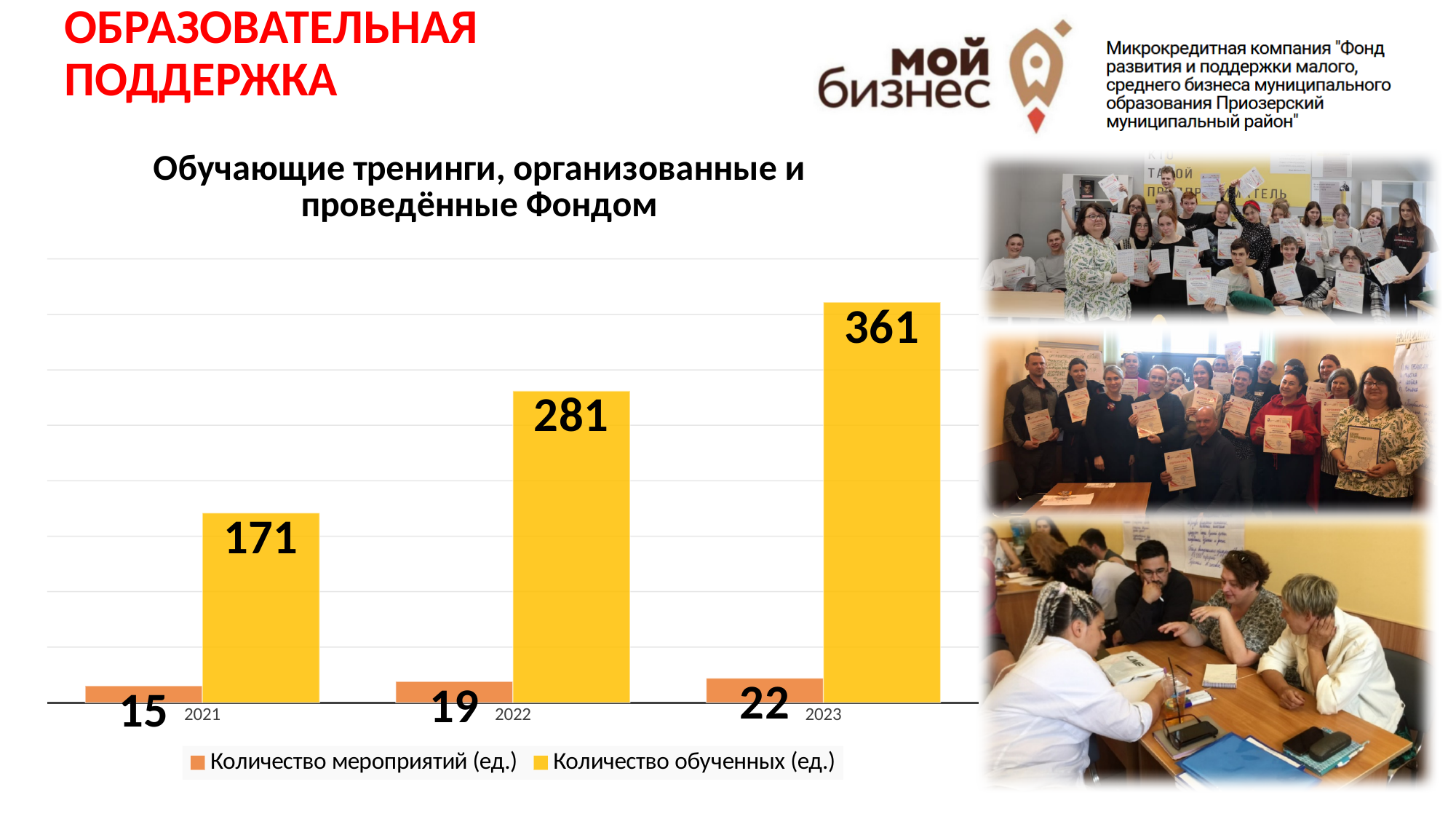
Which is larger: Количество обученных (ед.) in 2022 or in 2021? 2022 What is the value of Количество мероприятий (ед.) for 2021? 15 How many series does the chart legend list? 2 Which year has the highest value for Количество обученных (ед.)? 2023 Which year has the lowest value for Количество мероприятий (ед.)? 2021 What is the value of Количество обученных (ед.) for 2022? 281 What is the difference between Количество мероприятий (ед.) in 2022 and in 2021? 4 What kind of chart is shown on the slide? bar chart How many years are shown on the x axis of the chart? 3 What is the value of Количество обученных (ед.) for 2023? 361 What is the difference between Количество обученных (ед.) in 2023 and in 2021? 190 What is the value of Количество мероприятий (ед.) for 2023? 22